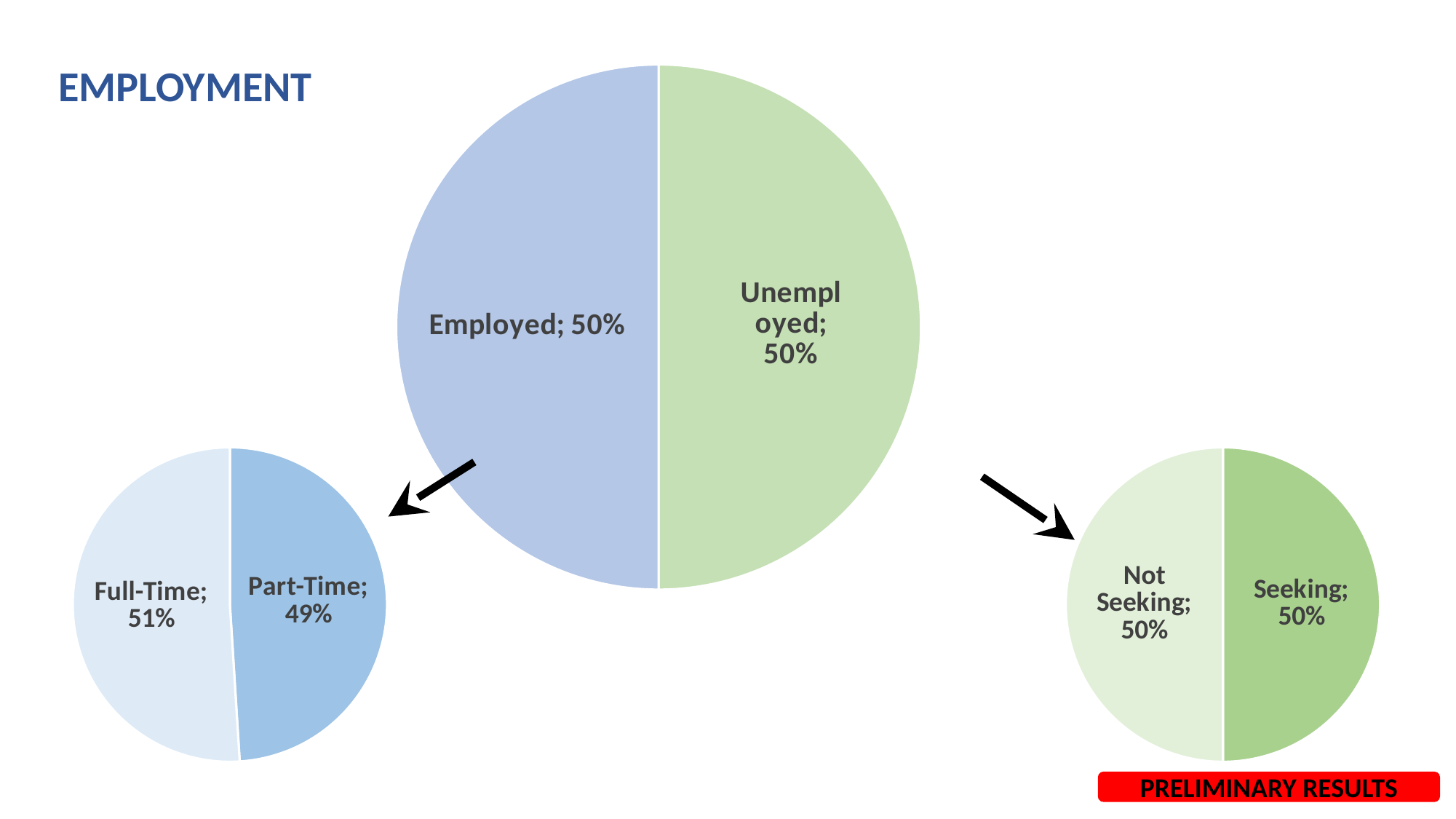
How many pie charts are shown on the slide? 3 In the bottom-right pie chart, what share is Not Seeking? 50% In the bottom-left pie chart, what share is Full-Time? 51% What kind of chart is the bottom-right chart? Pie chart In the bottom-right pie chart, what share is Seeking? 50% In the bottom-left pie chart, which slice is larger, Full-Time or Part-Time? Full-Time What is the title of the slide? EMPLOYMENT In the bottom-left pie chart, what share is Part-Time? 49% In the large central pie chart, what share is labelled Employed? 50% How many slices does the large central pie chart have? 2 In the bottom-left pie chart, what is the difference between the Full-Time and Part-Time shares? 2% In the large central pie chart, what share is labelled Unemployed? 50%